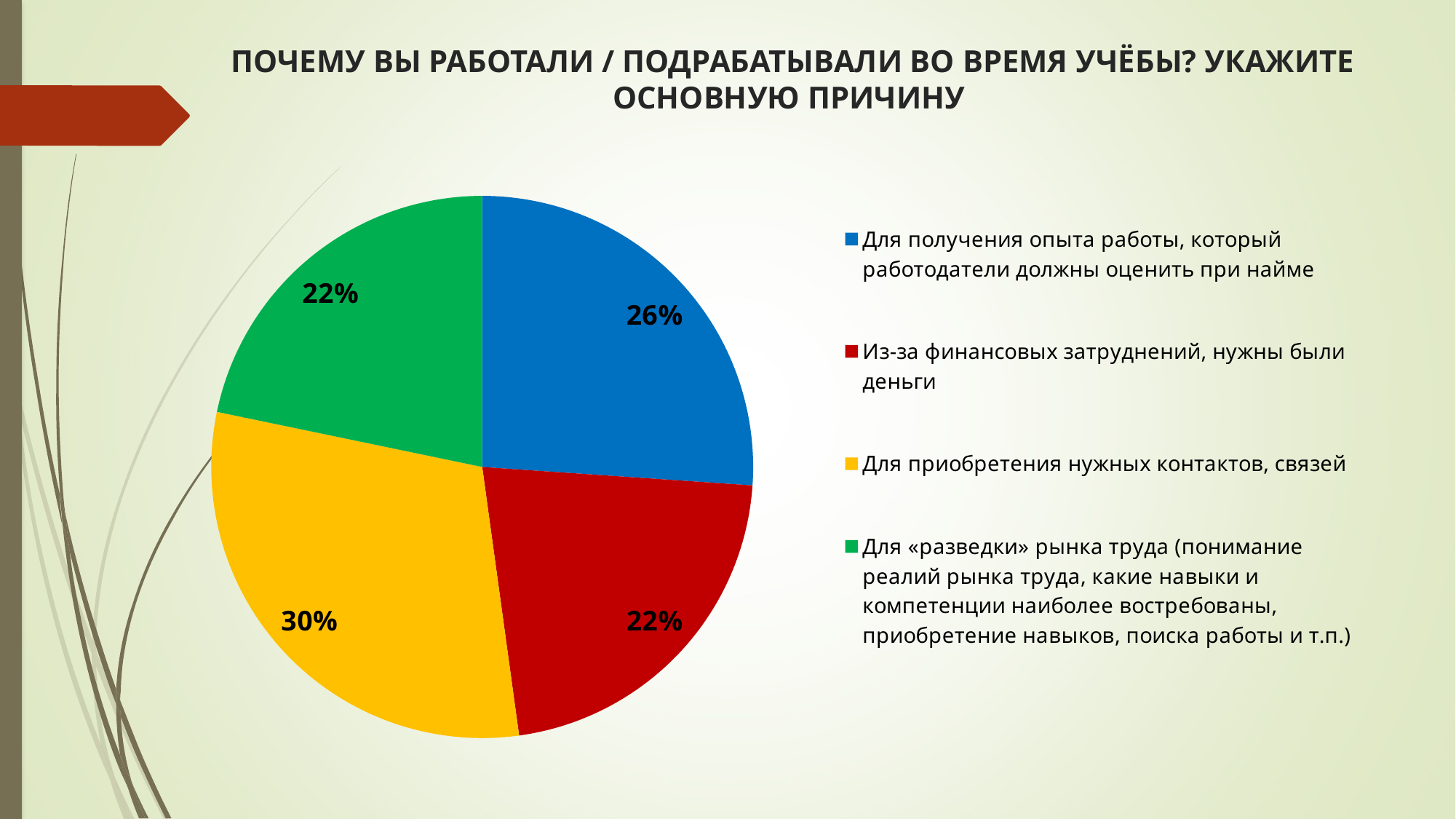
What share of respondents chose "Из-за финансовых затруднений, нужны были деньги"? 22% What colour is the slice for "Для приобретения нужных контактов, связей"? yellow What share of respondents chose "Для «разведки» рынка труда"? 22% Which is larger: the share for "Для получения опыта работы" or the share for "Из-за финансовых затруднений"? Для получения опыта работы Which reason has the largest share of the pie? Для приобретения нужных контактов, связей What share of respondents chose "Для приобретения нужных контактов, связей"? 30% What kind of chart is shown on the slide? pie chart What is the difference in percentage points between the share for "Для приобретения нужных контактов, связей" and the share for "Для получения опыта работы"? 4 How many entries does the legend list? 4 How many slices does the pie chart have? 4 What colour is the slice for "Из-за финансовых затруднений, нужны были деньги"? red What share of respondents chose "Для получения опыта работы, который работодатели должны оценить при найме"? 26%